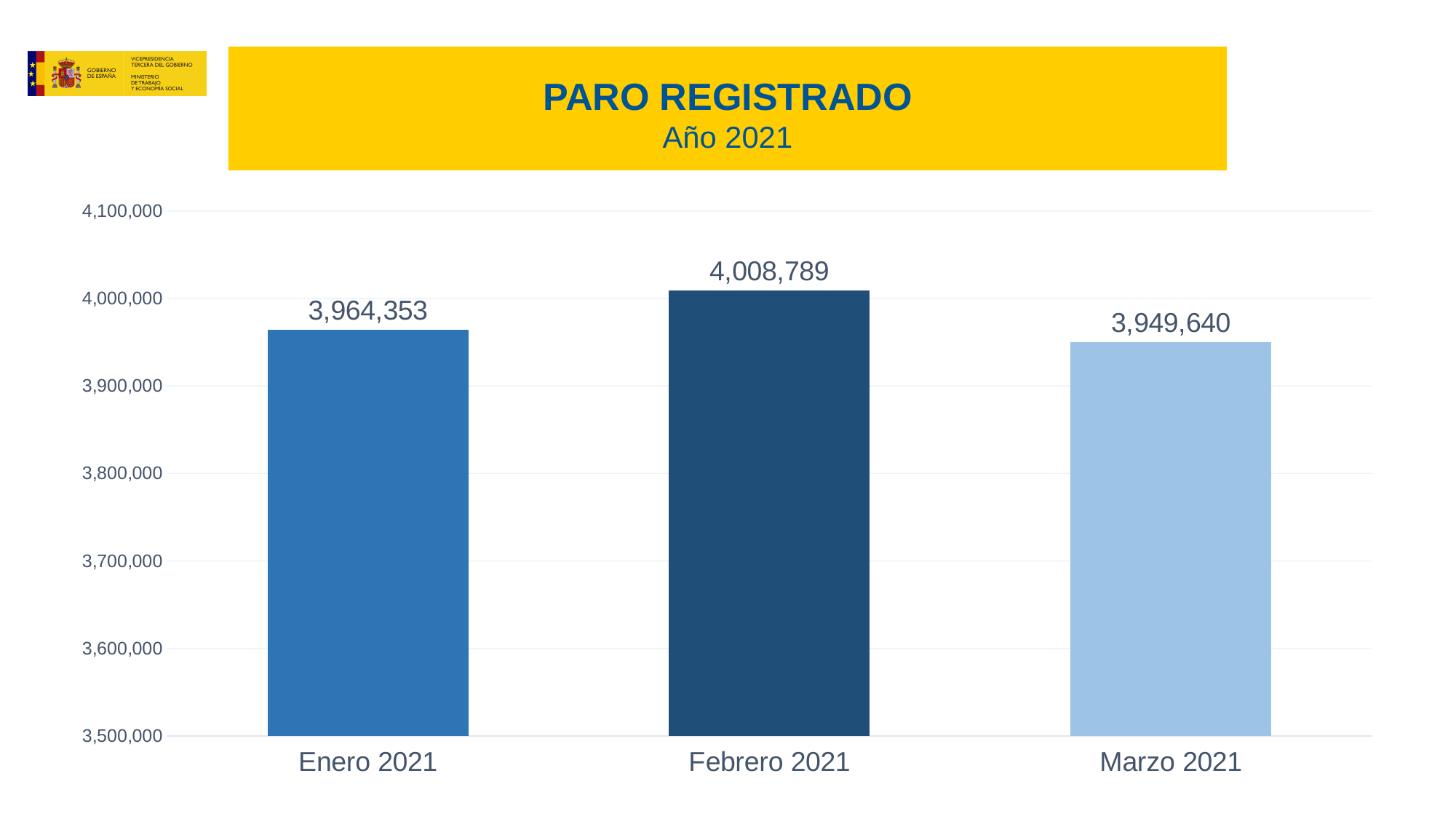
What is the value for Febrero 2021? 4,008,789 What is the difference between the values for Febrero 2021 and Enero 2021? 44,436 What is the difference between the values for Enero 2021 and Marzo 2021? 14,713 Which month has the lowest value? Marzo 2021 What kind of chart is shown on the slide? bar chart Is the value for Febrero 2021 greater or less than 4,000,000? greater What is the title of the chart? PARO REGISTRADO Año 2021 What is the value for Marzo 2021? 3,949,640 What is the value for Enero 2021? 3,964,353 Which month has the highest value? Febrero 2021 Which is larger, the value for Enero 2021 or the value for Marzo 2021? Enero 2021 How many months are shown in the chart? 3